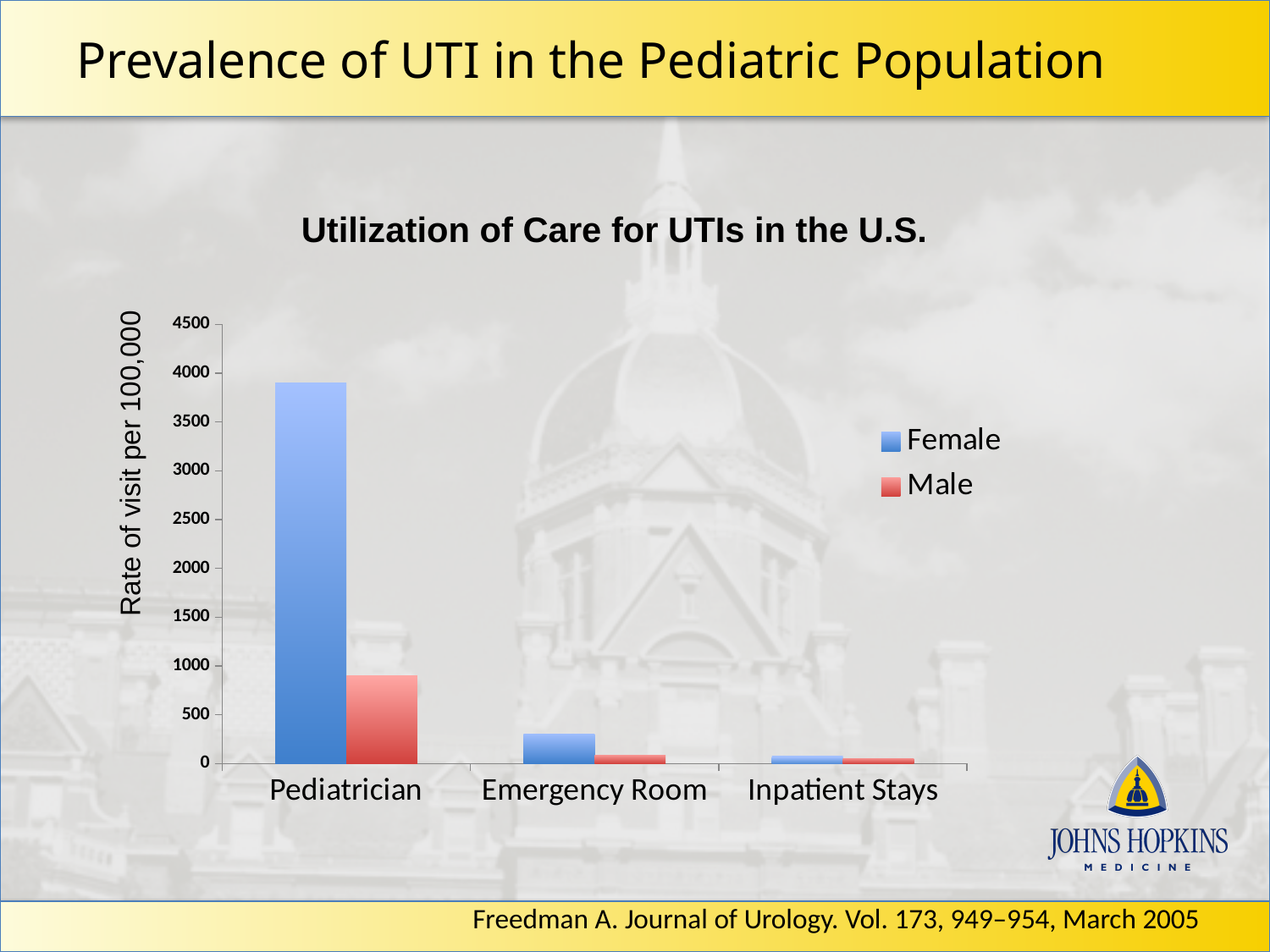
What kind of chart is shown on the slide? Bar chart Is the Male value for Pediatrician greater or less than 1000? less Which category has the lowest Female value? Inpatient Stays Is the Female value for Pediatrician greater or less than 3500? greater How many series does the legend list? 2 Which category has the highest Female value? Pediatrician For Pediatrician, which is larger, the Female value or the Male value? Female What is the label of the vertical axis? Rate of visit per 100,000 Is the Female value for Emergency Room greater or less than 500? less How many categories are shown on the x axis? 3 Do the Female values rise or fall from Pediatrician to Inpatient Stays along the x axis? fall What is the title of the chart? Utilization of Care for UTIs in the U.S.